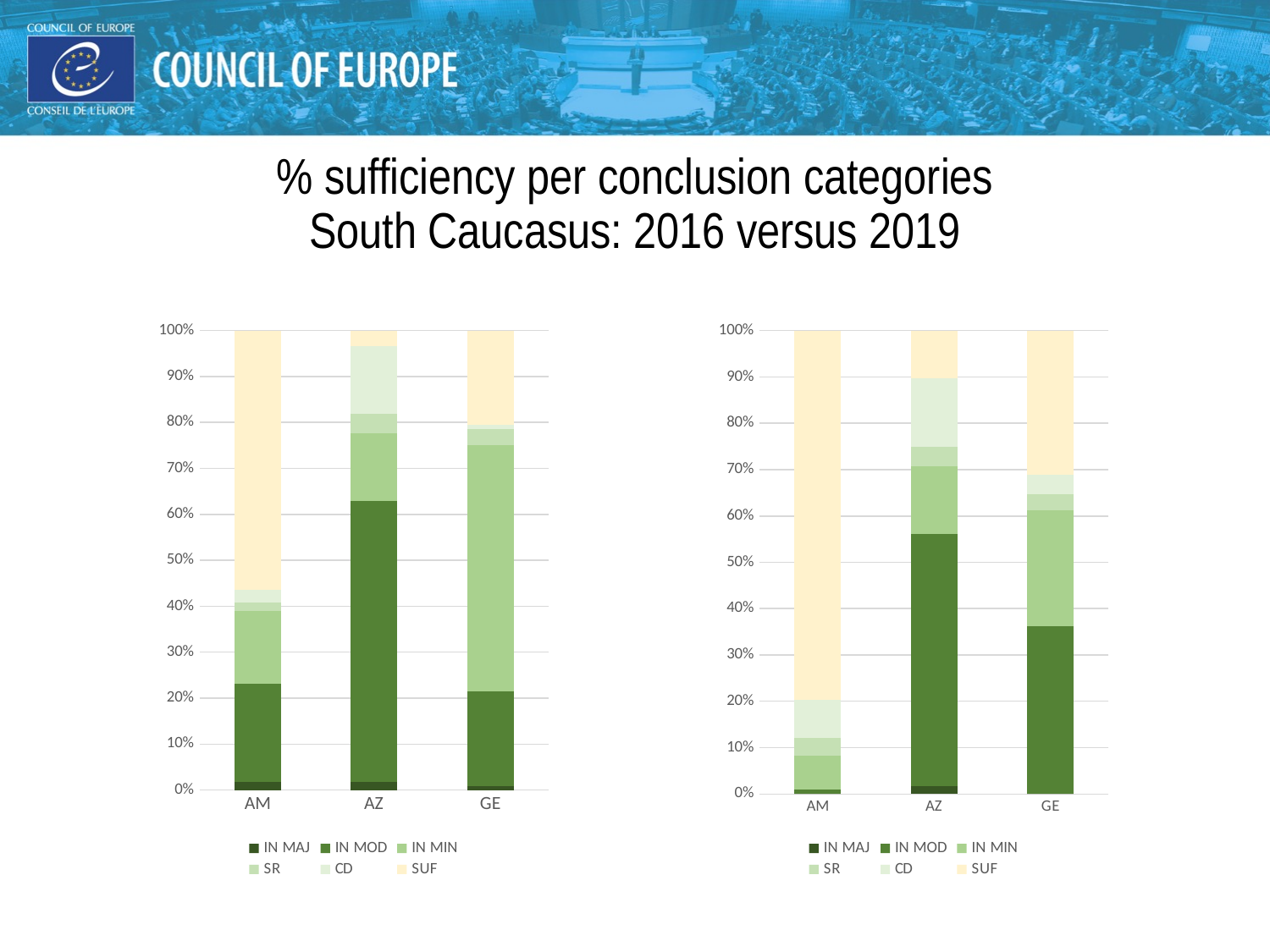
What kind of chart is the left chart on the slide? Stacked bar chart In the right chart, is the SUF value for GE greater or less than 20%? greater In the left chart, is the SUF value for AM greater or less than 50%? greater Which legend entry in the right chart is shown in pale yellow? SUF In the left chart, which has the larger IN MOD segment, AM or AZ? AZ In the left chart, is the SUF value for AZ greater or less than 10%? less In the right chart, which category has the smallest SUF segment? AZ In the left chart, which category has the largest SUF segment? AM How many categories are shown on the x axis of the right chart? 3 How many series does the legend of the left chart list? 6